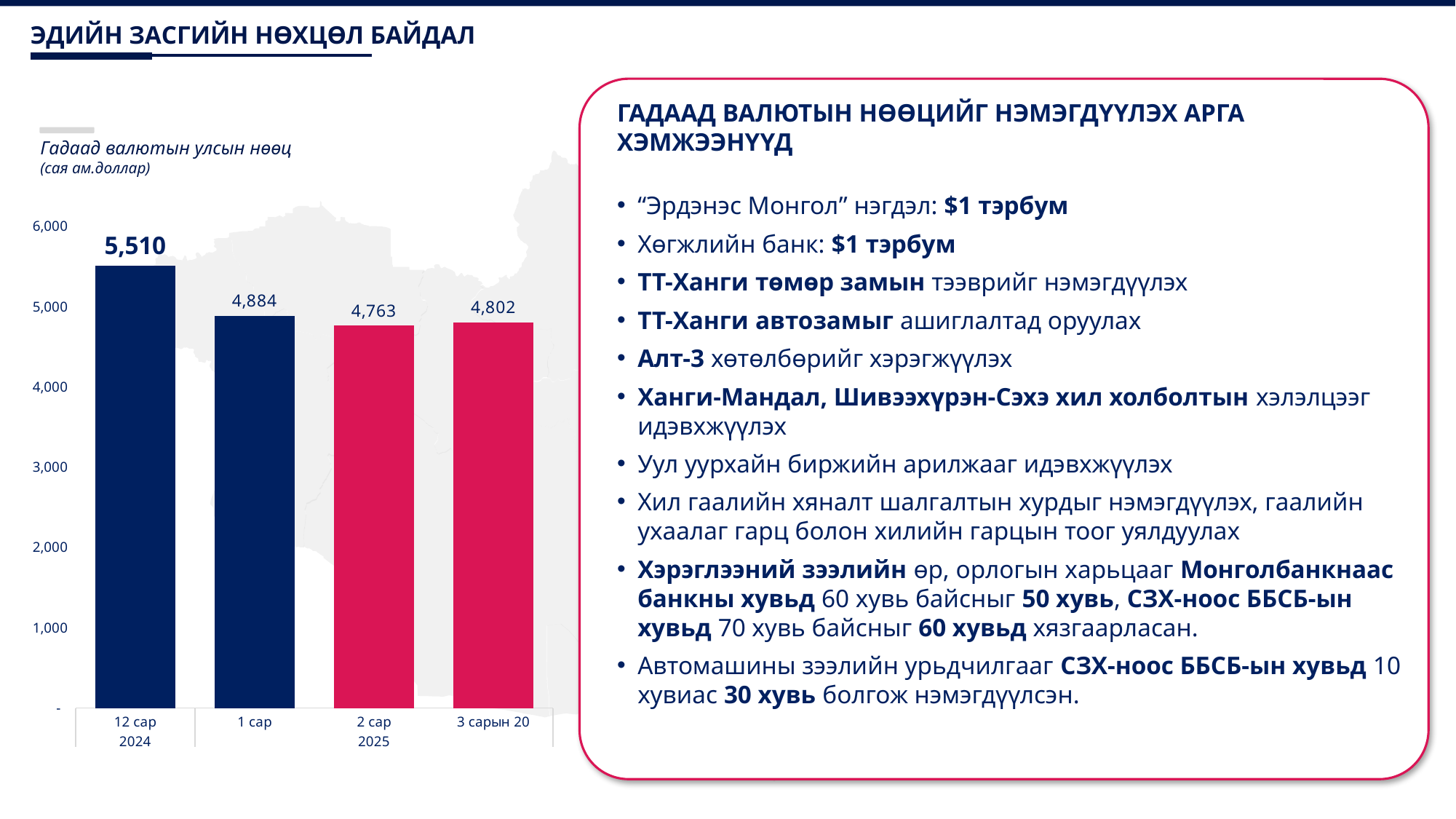
What type of chart is shown on the slide? Bar chart How many bars are plotted in the chart? 4 What value is shown for 1 сар 2025? 4,884 Which period has the lowest value in the chart? 2 сар 2025 Which period has the highest value in the chart? 12 сар 2024 Which is larger, the value for 1 сар 2025 or the value for 3 сарын 20? 1 сар 2025 What unit is stated under the chart title? сая ам.доллар What is the difference between the values for 12 сар 2024 and 1 сар 2025? 626 What is the foreign currency reserve value shown for 12 сар 2024? 5,510 What value is shown for 3 сарын 20? 4,802 What is the difference between the values for 3 сарын 20 and 2 сар 2025? 39 What value is shown for 2 сар 2025? 4,763